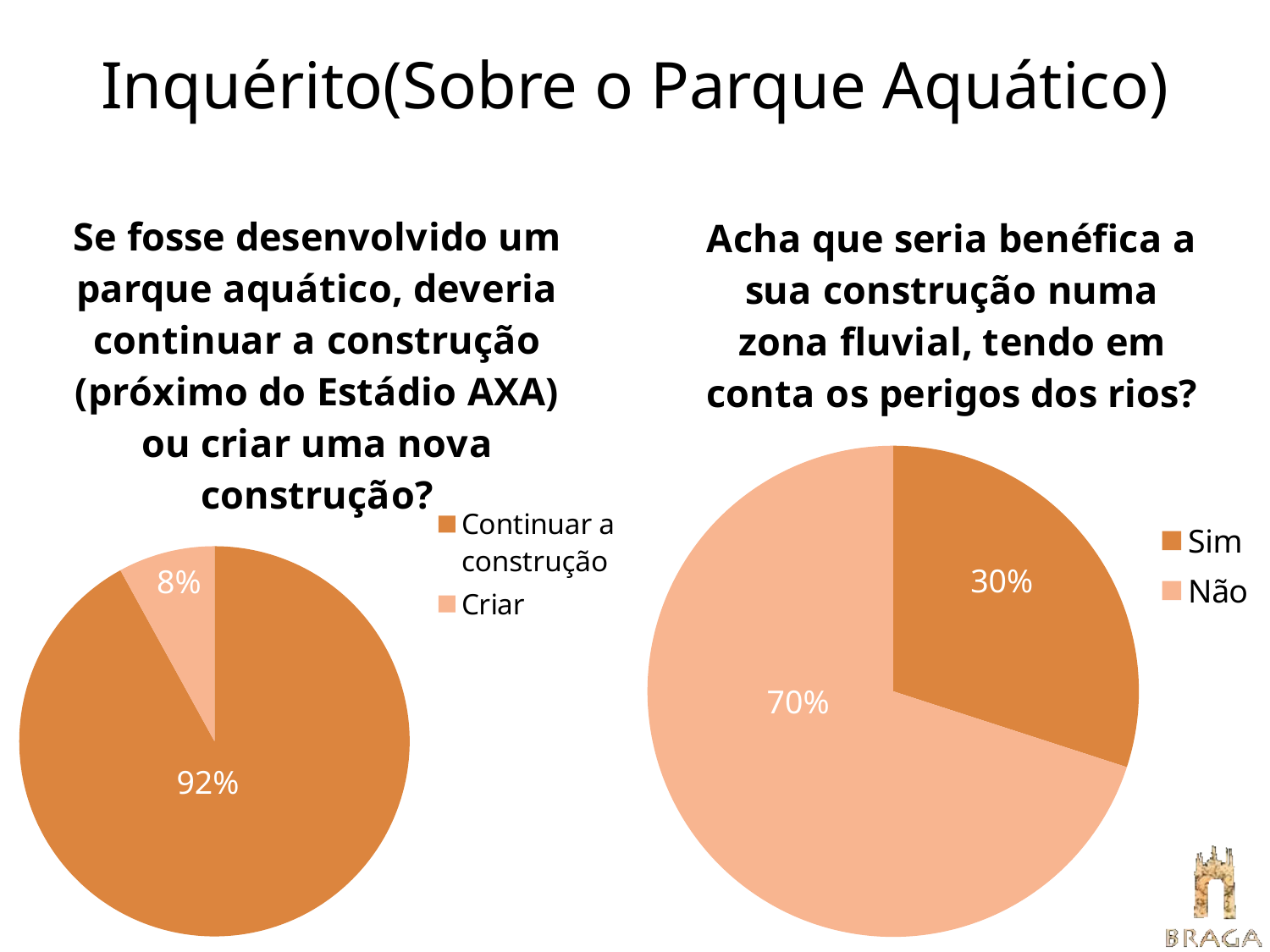
In the left pie chart, what share of responses is 'Continuar a construção'? 92% In the left pie chart, what is the difference in percentage points between 'Continuar a construção' and 'Criar'? 84 How many entries does the legend of the right pie chart list? 2 In the right pie chart, what is the difference in percentage points between 'Não' and 'Sim'? 40 In the left pie chart, which category has the largest share? Continuar a construção How many slices does the left pie chart have? 2 In the right pie chart, which category has the smallest share? Sim What kind of chart is the right chart on the slide? Pie chart In the right pie chart, what share of responses is 'Não'? 70% In the right pie chart, which is larger, 'Sim' or 'Não'? Não In the left pie chart, what share of responses is 'Criar'? 8% In the right pie chart, what share of responses is 'Sim'? 30%